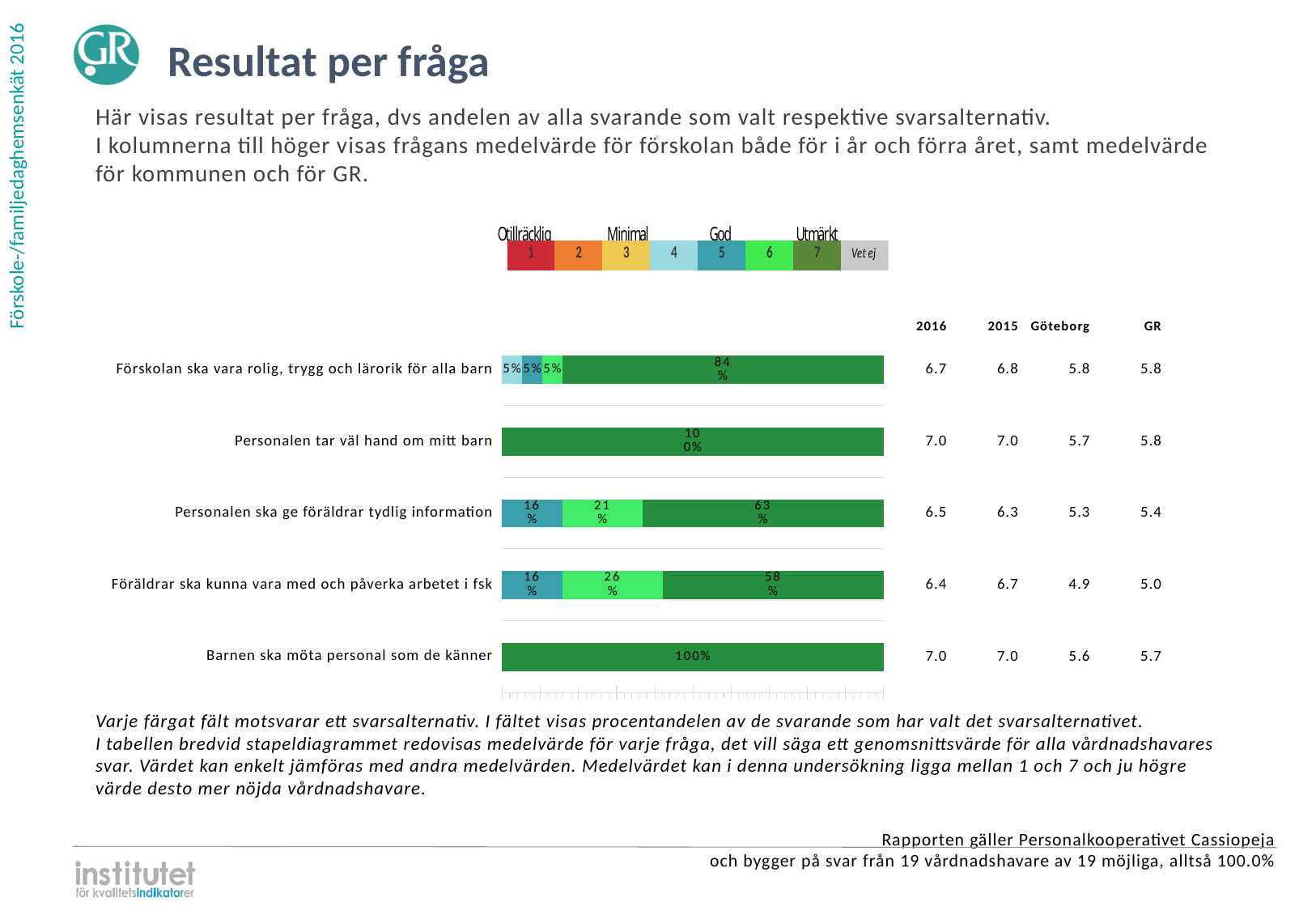
What percentage of respondents chose answer 7 (dark green) for "Förskolan ska vara rolig, trygg och lärorik för alla barn"? 84% What percentage is shown for the light green segment (answer 6) of "Föräldrar ska kunna vara med och påverka arbetet i fsk"? 26% What percentage is shown for the dark green segment of "Personalen ska ge föräldrar tydlig information"? 63% What percentage is shown for the teal segment (answer 5) of "Personalen ska ge föräldrar tydlig information"? 16% Is the light green (answer 6) share larger for "Föräldrar ska kunna vara med och påverka arbetet i fsk" or for "Personalen ska ge föräldrar tydlig information"? Föräldrar ska kunna vara med och påverka arbetet i fsk Which question has the smallest dark green (answer 7) share? Föräldrar ska kunna vara med och påverka arbetet i fsk What kind of chart is shown on the slide? stacked bar chart How many answer options does the legend above the chart list, including "Vet ej"? 8 Which question has the largest dark green (answer 7) share? Personalen tar väl hand om mitt barn and Barnen ska möta personal som de känner (100%) What percentage is shown for the bar "Barnen ska möta personal som de känner"? 100% How many questions (categories) are plotted in the bar chart? 5 What is the difference between the dark green shares of "Personalen ska ge föräldrar tydlig information" (63%) and "Föräldrar ska kunna vara med och påverka arbetet i fsk" (58%)? 5%